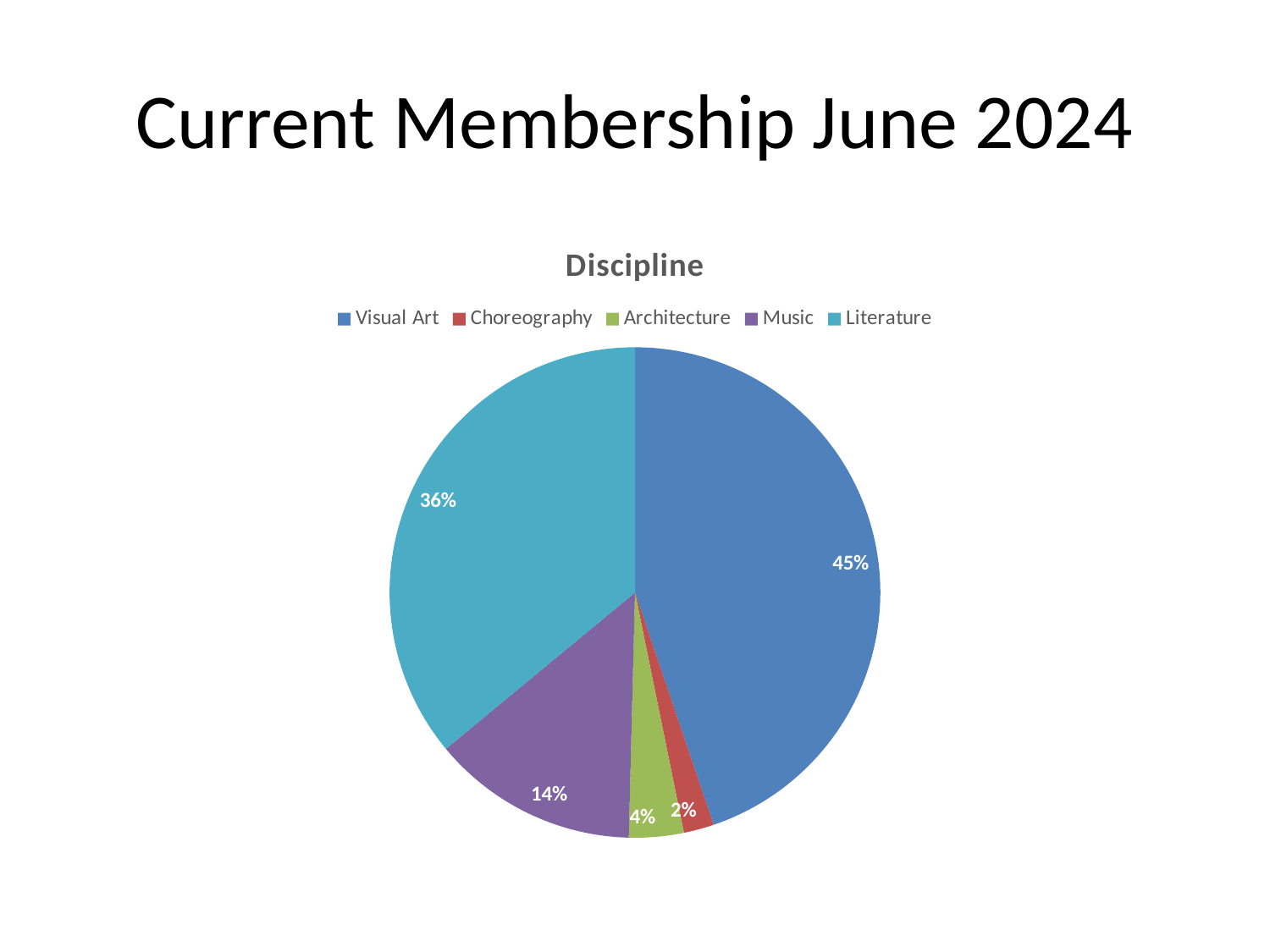
What share of the pie does Literature have? 36% What share of the pie does Choreography have? 2% How many disciplines are shown in the pie chart? 5 Which discipline has the largest share of the pie? Visual Art What kind of chart is shown on the slide? Pie chart What is the difference in percentage points between Visual Art and Literature? 9 What share of the pie does Visual Art have? 45% What is the title of the chart? Discipline Which has a larger share, Music or Architecture? Music Which discipline has the smallest share of the pie? Choreography